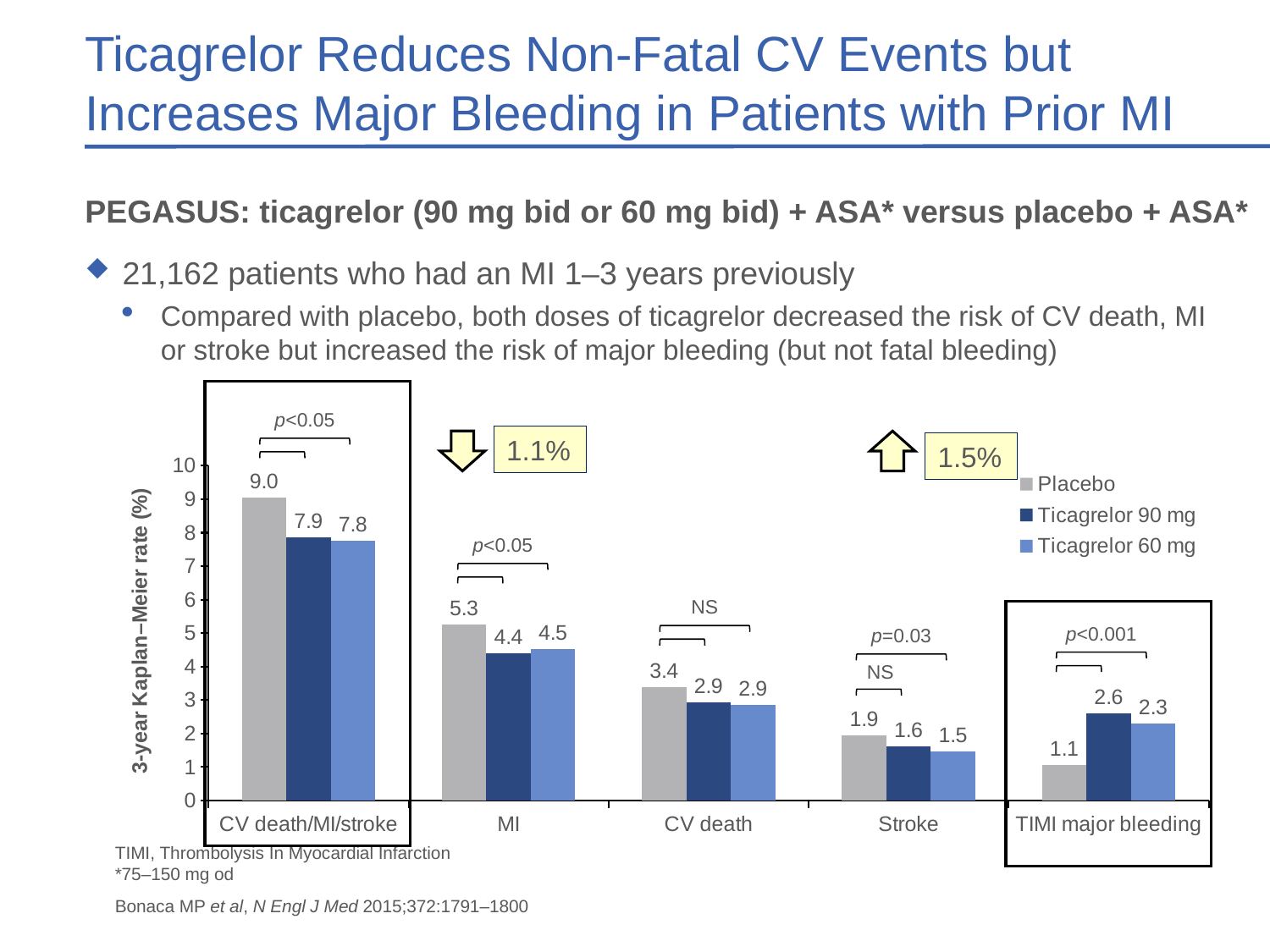
What is the label of the y axis? 3-year Kaplan–Meier rate (%) Which category has the highest Placebo value? CV death/MI/stroke Which category has the lowest Placebo value? TIMI major bleeding What is the value for Ticagrelor 90 mg in the MI category? 4.4 In the TIMI major bleeding category, which is larger: the Placebo value or the Ticagrelor 90 mg value? Ticagrelor 90 mg What is the value for Ticagrelor 60 mg in the TIMI major bleeding category? 2.3 What kind of chart is shown on the slide? Bar chart How many series does the legend list? 3 What is the difference between the Placebo and Ticagrelor 60 mg values in the Stroke category? 0.4 What is the 3-year Kaplan–Meier rate for Placebo in the CV death/MI/stroke category? 9.0 What is the difference between the Placebo and Ticagrelor 90 mg values in the CV death/MI/stroke category? 1.1 How many categories are shown on the x axis? 5